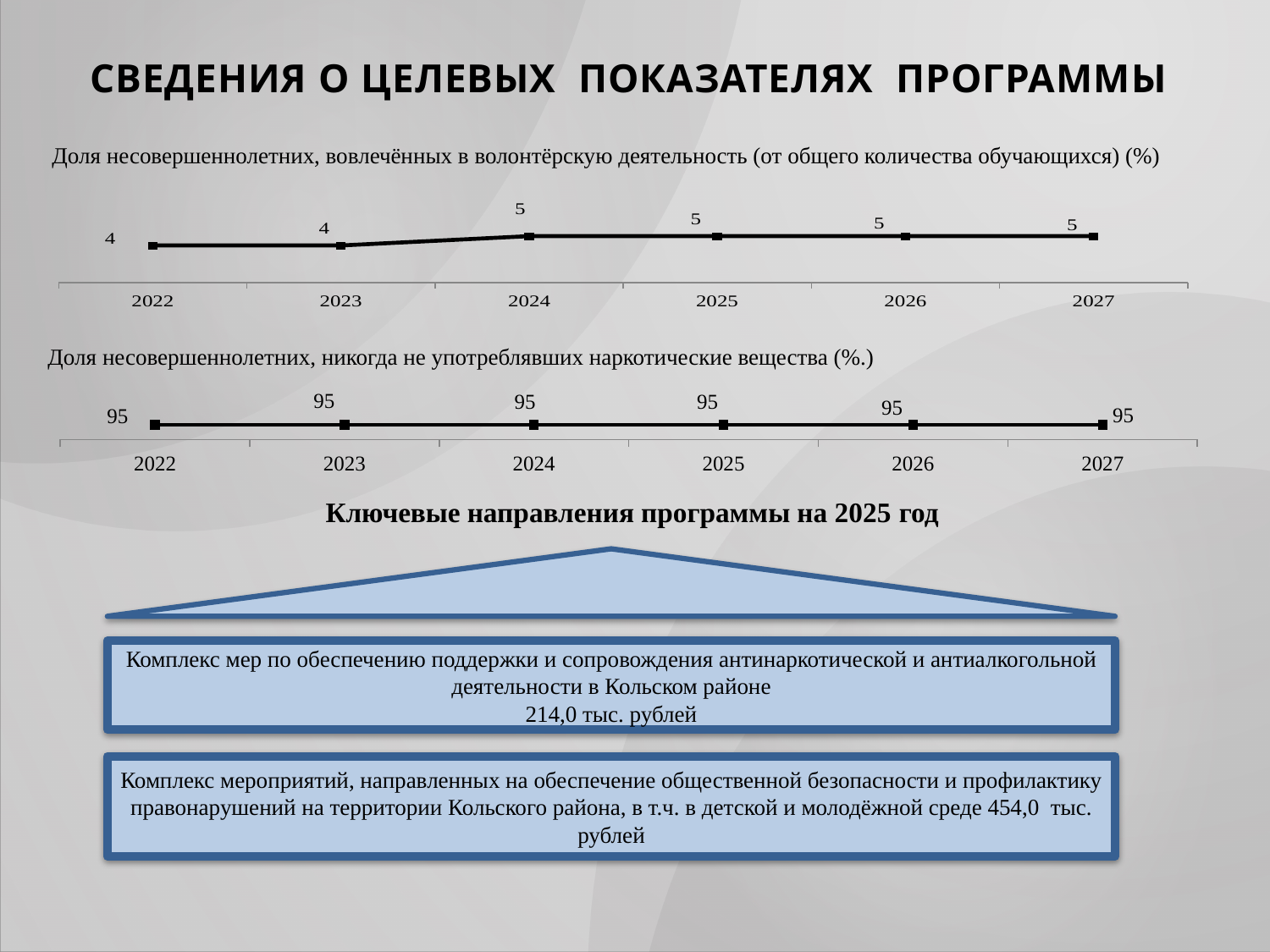
How many years are plotted in the bottom chart (share of minors who have never used narcotic substances)? 6 In the bottom chart (share of minors who have never used narcotic substances), what is the value for 2022? 95 In the bottom chart (share of minors who have never used narcotic substances), what is the value for 2026? 95 How many years are plotted in the top chart (share of minors involved in volunteer activity)? 6 In the bottom chart (share of minors who have never used narcotic substances), what is the difference between the values for 2027 and 2022? 0 In the top chart (share of minors involved in volunteer activity), do the values rise or fall from 2022 to 2027? rise In the top chart (share of minors involved in volunteer activity), what is the value for 2024? 5 In the top chart (share of minors involved in volunteer activity), what is the difference between the values for 2024 and 2023? 1 In the top chart (share of minors involved in volunteer activity), what is the value for 2027? 5 What kind of chart is the top chart (share of minors involved in volunteer activity)? line chart In the top chart (share of minors involved in volunteer activity), what is the value for 2022? 4 In the top chart (share of minors involved in volunteer activity), which is larger, the value for 2023 or the value for 2025? 2025